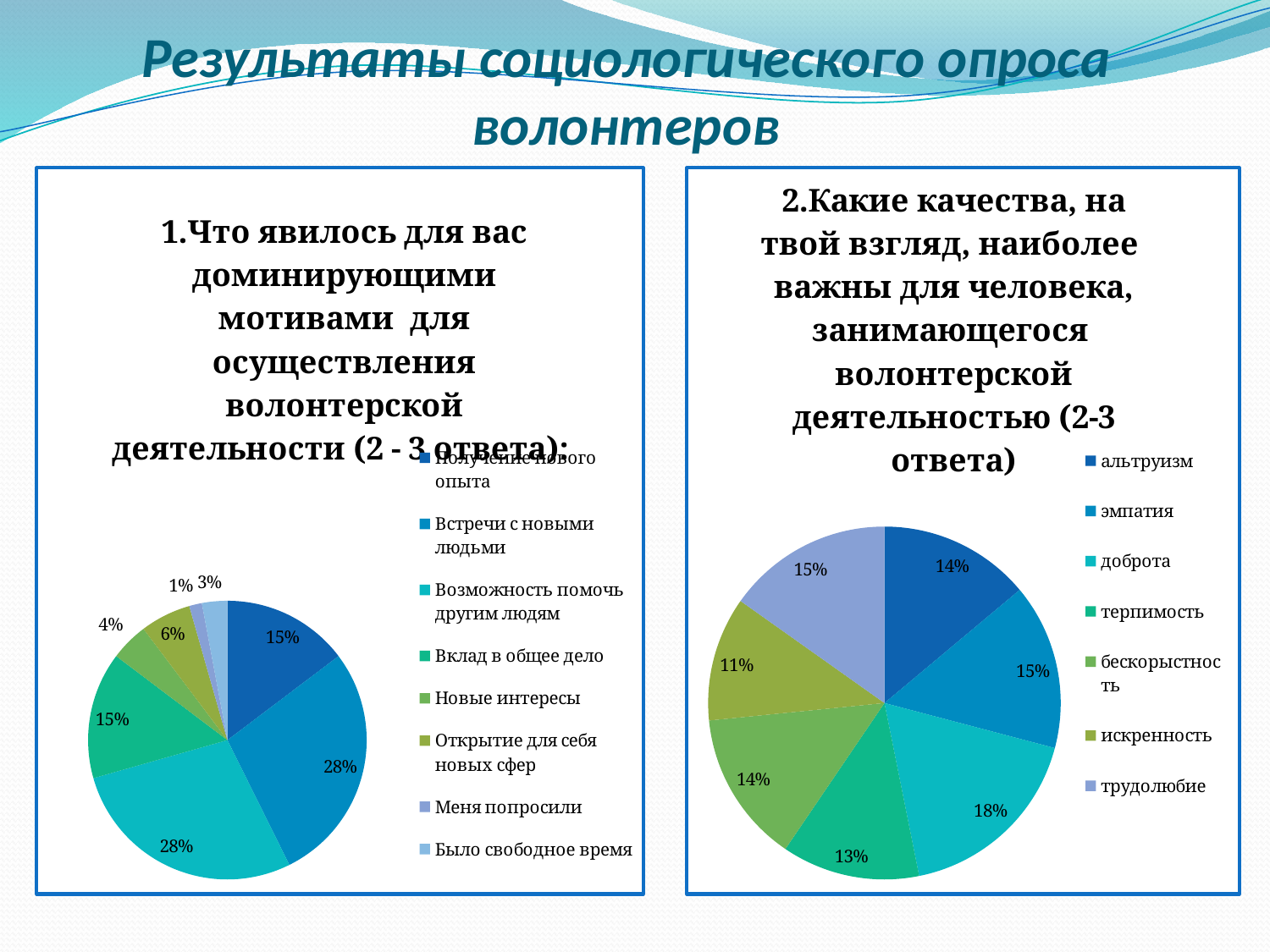
In the left chart about dominant motives for volunteering, which is larger: 'Новые интересы' or 'Открытие для себя новых сфер'? Открытие для себя новых сфер In the right chart about important qualities for a volunteer, which quality has the largest share? доброта In the left chart about dominant motives for volunteering, what share is labelled for 'Вклад в общее дело'? 15% In the right chart about important qualities for a volunteer, how many qualities does the legend list? 7 In the right chart about important qualities for a volunteer, what share is labelled for 'доброта'? 18% In the right chart about important qualities for a volunteer, what share is labelled for 'альтруизм'? 14% What kind of chart is used in the left chart about dominant motives for volunteering? pie chart In the right chart about important qualities for a volunteer, what is the difference between the shares for 'доброта' and 'терпимость'? 5% In the left chart about dominant motives for volunteering, what share is labelled for 'Открытие для себя новых сфер'? 6% In the right chart about important qualities for a volunteer, which quality has the smallest share? искренность In the left chart about dominant motives for volunteering, how many categories does the legend list? 8 In the left chart about dominant motives for volunteering, which category has the smallest share? Меня попросили